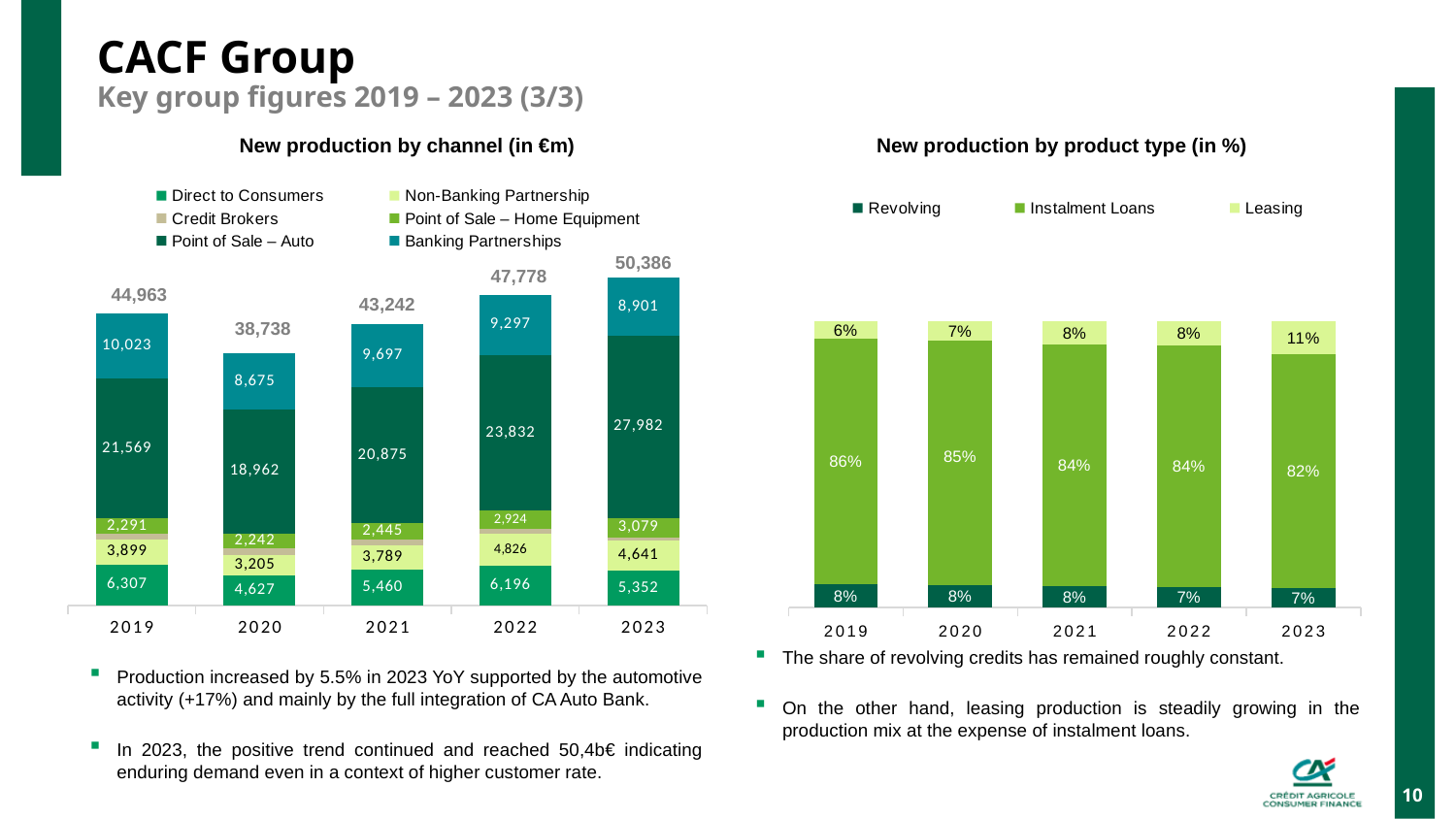
What kind of chart is the 'New production by channel (in €m)' chart? Stacked bar chart In the 'New production by product type (in %)' chart, what is the share of Leasing in 2023? 11% In the 'New production by channel (in €m)' chart, what is the total new production for 2023? 50,386 In the 'New production by channel (in €m)' chart, what is the difference between the 2023 total and the 2022 total? 2,608 In the 'New production by product type (in %)' chart, what is the share of Instalment Loans in 2019? 86% In the 'New production by channel (in €m)' chart, which year has the lowest total new production? 2020 How many series does the legend of the 'New production by product type (in %)' chart list? 3 In the 'New production by channel (in €m)' chart, what is the value of the Point of Sale – Auto segment in 2023? 27,982 How many series does the legend of the 'New production by channel (in €m)' chart list? 6 In the 'New production by product type (in %)' chart, does the share of Leasing rise or fall from 2019 to 2023? Rise In the 'New production by product type (in %)' chart, is the Revolving share larger in 2019 or in 2023? 2019 How many years are shown on the x axis of the 'New production by product type (in %)' chart? 5